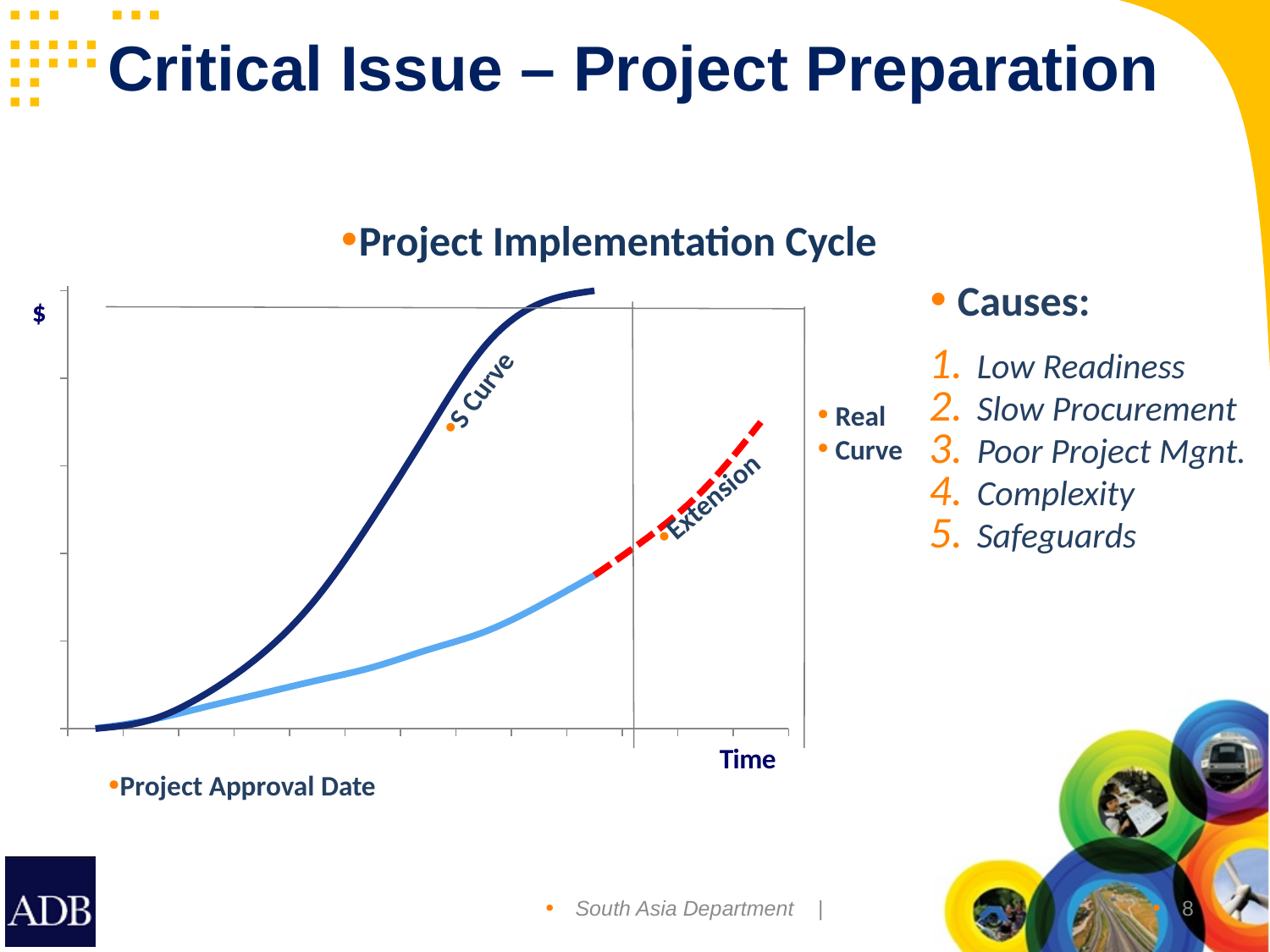
What is the title of the chart? Project Implementation Cycle Which curve reaches the top of the chart first, the S Curve or the Real Curve? S Curve At the vertical line marking the end of the planned period, which curve is higher, the S Curve or the Real Curve? S Curve Does the Real Curve rise or fall along the Time axis? rises Which curve is drawn as a red dashed line? Extension Does the S Curve rise or fall as time increases? rises What kind of chart is shown on the slide? line chart How many curves are plotted on the chart? 3